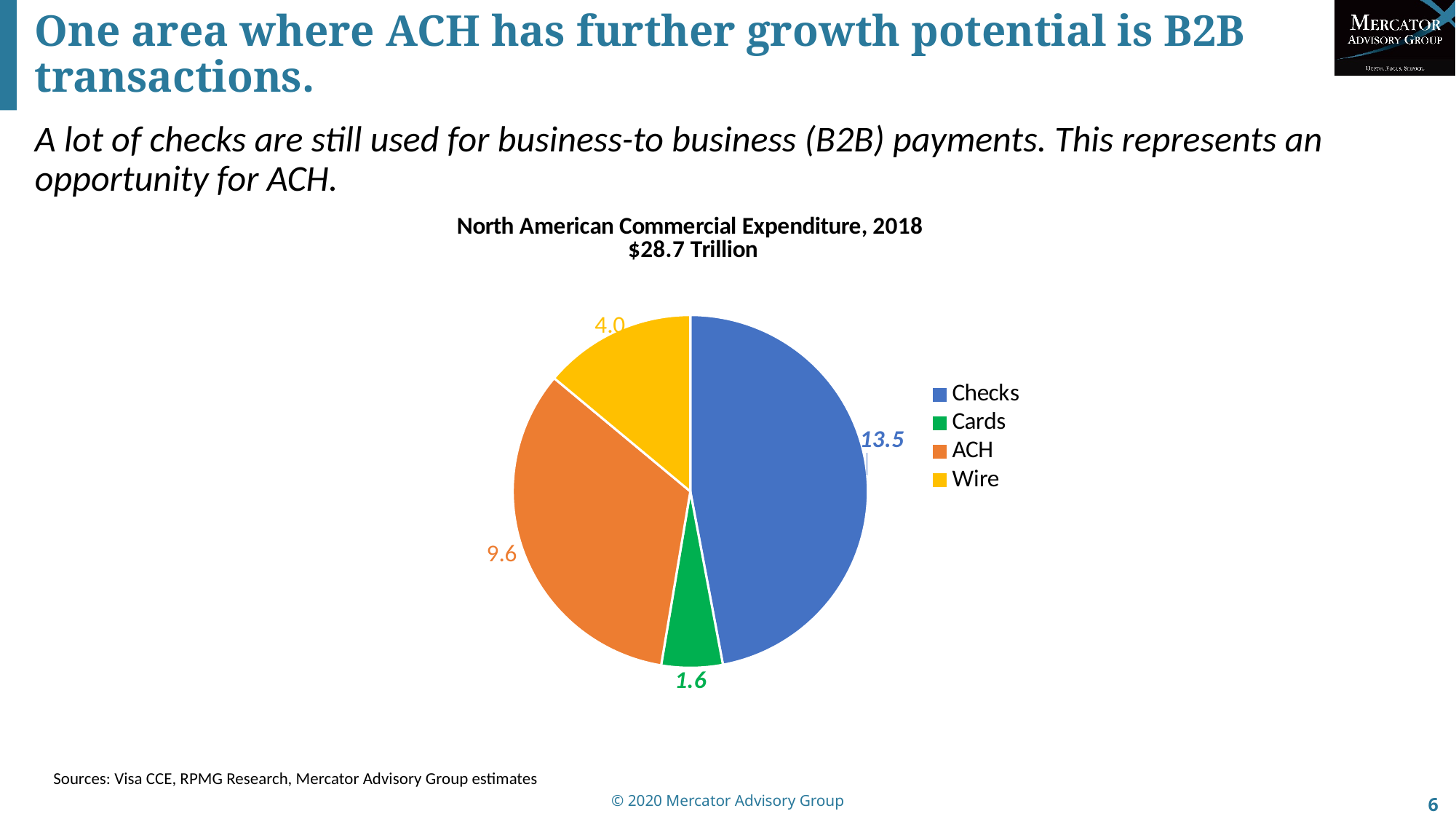
What is the value for ACH in the pie chart? 9.6 Which category has the smallest slice of the pie? Cards How many categories does the legend list? 4 What is the difference between the values for Checks and ACH? 3.9 What is the value for Checks in the pie chart? 13.5 What is the title of the chart? North American Commercial Expenditure, 2018 $28.7 Trillion What type of chart is shown on the slide? Pie chart Which is larger, the value for ACH or the value for Wire? ACH What is the value for Cards in the pie chart? 1.6 What is the value for Wire in the pie chart? 4.0 Which category has the largest slice of the pie? Checks What colour is the ACH slice in the pie chart? Orange